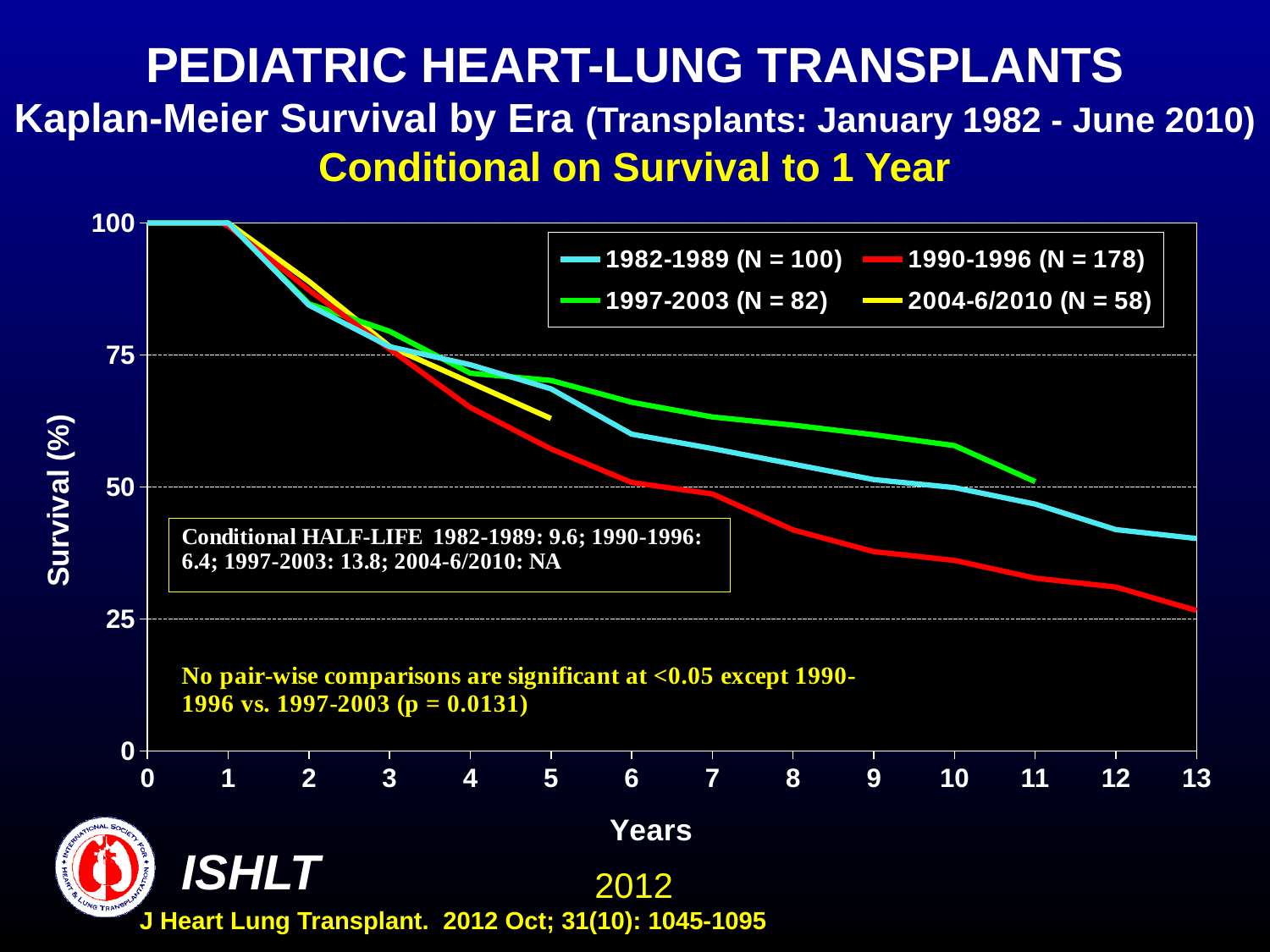
What is the N for the 2004-6/2010 era shown in the legend? 58 Is the survival value for the 1990-1996 era at 13 years greater or less than 50? less What is the difference between the N for 1990-1996 and the N for 1982-1989? 78 Which era has the largest N in the legend? 1990-1996 Do the survival curves rise or fall as years increase along the x axis? Fall How many series does the legend list? 4 Is the survival value for the 1997-2003 era at 10 years greater or less than 50? greater What is the N for the 1990-1996 era shown in the legend? 178 Which era has the smallest N in the legend? 2004-6/2010 What is the conditional half-life for the 1997-2003 era stated on the slide? 13.8 At 13 years, which era has the higher survival: 1982-1989 or 1990-1996? 1982-1989 What kind of chart is shown on the slide? Line chart